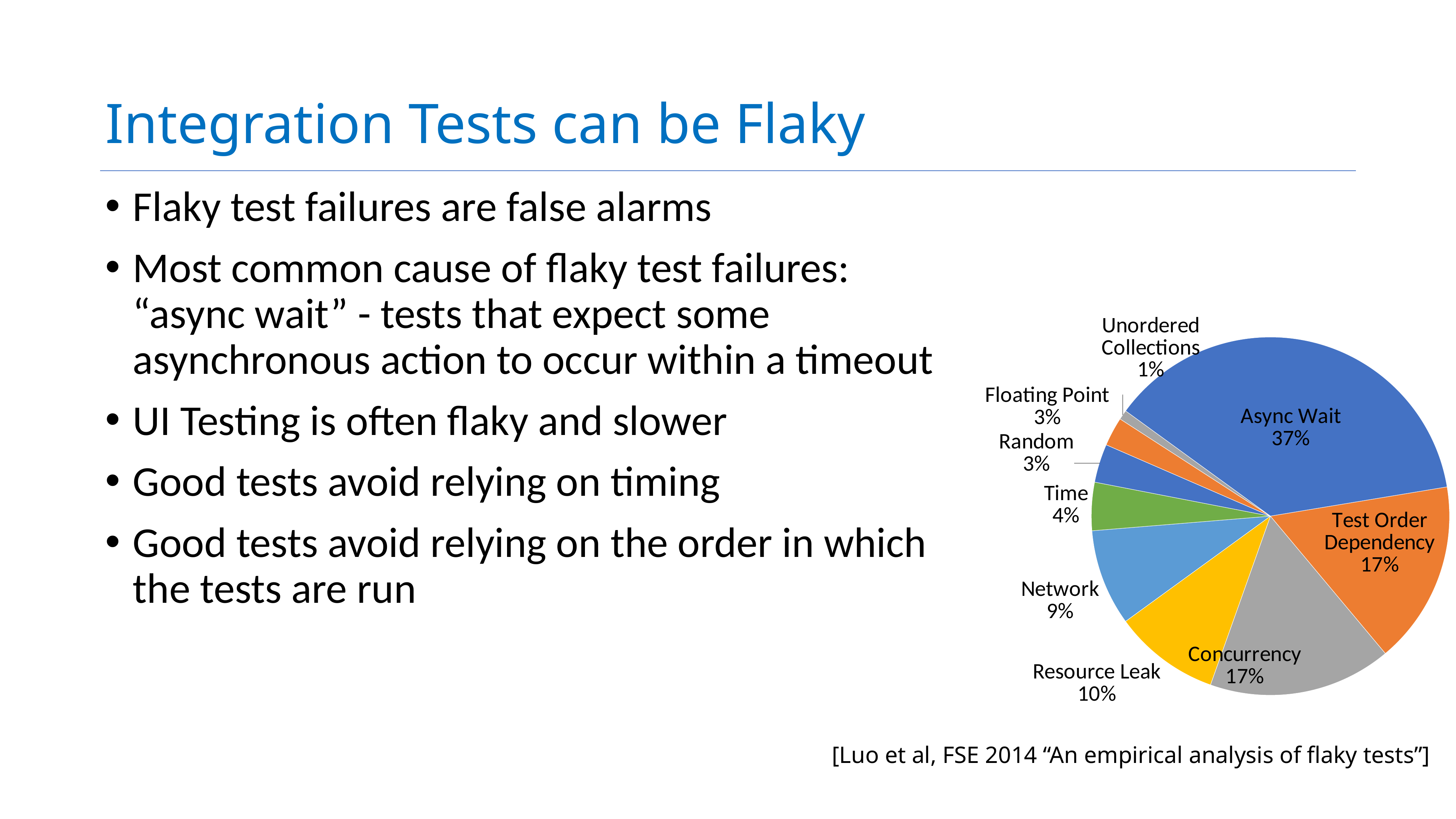
What percentage is shown for Time? 4% What kind of chart is shown on the slide? pie chart What is the difference in percentage points between Async Wait and Test Order Dependency? 20 What percentage is shown for Resource Leak? 10% Which category has the largest slice of the pie? Async Wait How many categories are shown in the pie chart? 9 Which category has the smallest slice of the pie? Unordered Collections What colour is the Async Wait slice? blue What percentage is shown for Unordered Collections? 1% What share of the pie does Async Wait account for? 37% Which is larger, the share for Resource Leak or the share for Network? Resource Leak What percentage is shown for Network? 9%